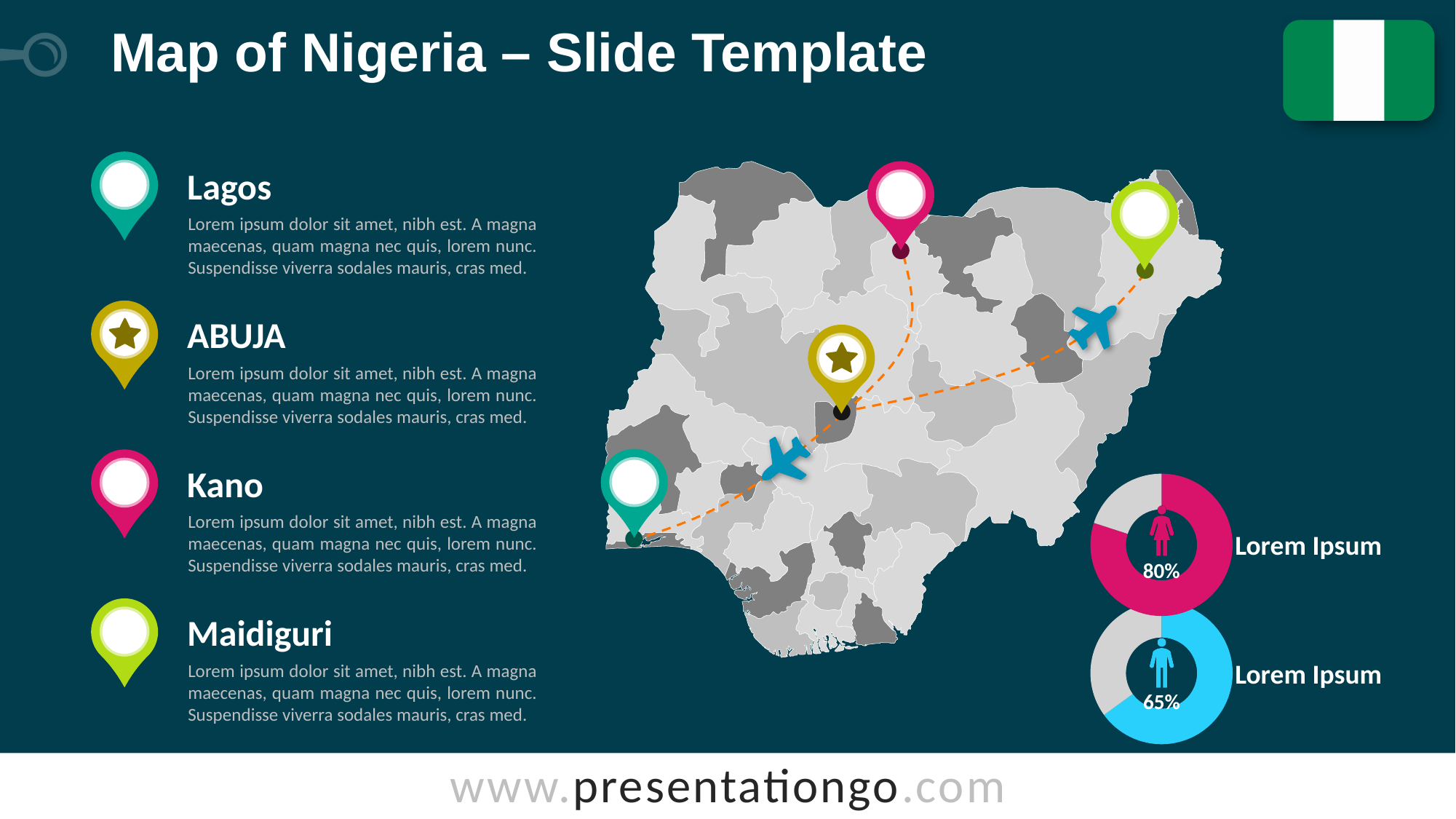
What kind of charts are the two circular charts on the right side of the slide? Donut charts What label text appears next to each of the two donut charts? Lorem Ipsum What colour is the filled portion of the upper donut chart? Pink (magenta) What share of the upper donut chart is filled in? 80% What percentage is shown in the lower donut chart on the right of the slide? 65% What percentage is shown in the upper donut chart on the right of the slide? 80% Which donut chart shows the larger percentage, the upper one or the lower one? The upper one (80%) What share of the lower donut chart is left unfilled? 35% What is the difference between the percentages shown in the upper and lower donut charts? 15 percentage points How many donut charts are on the slide? 2 Is the value shown in the lower donut chart greater or less than 50%? greater